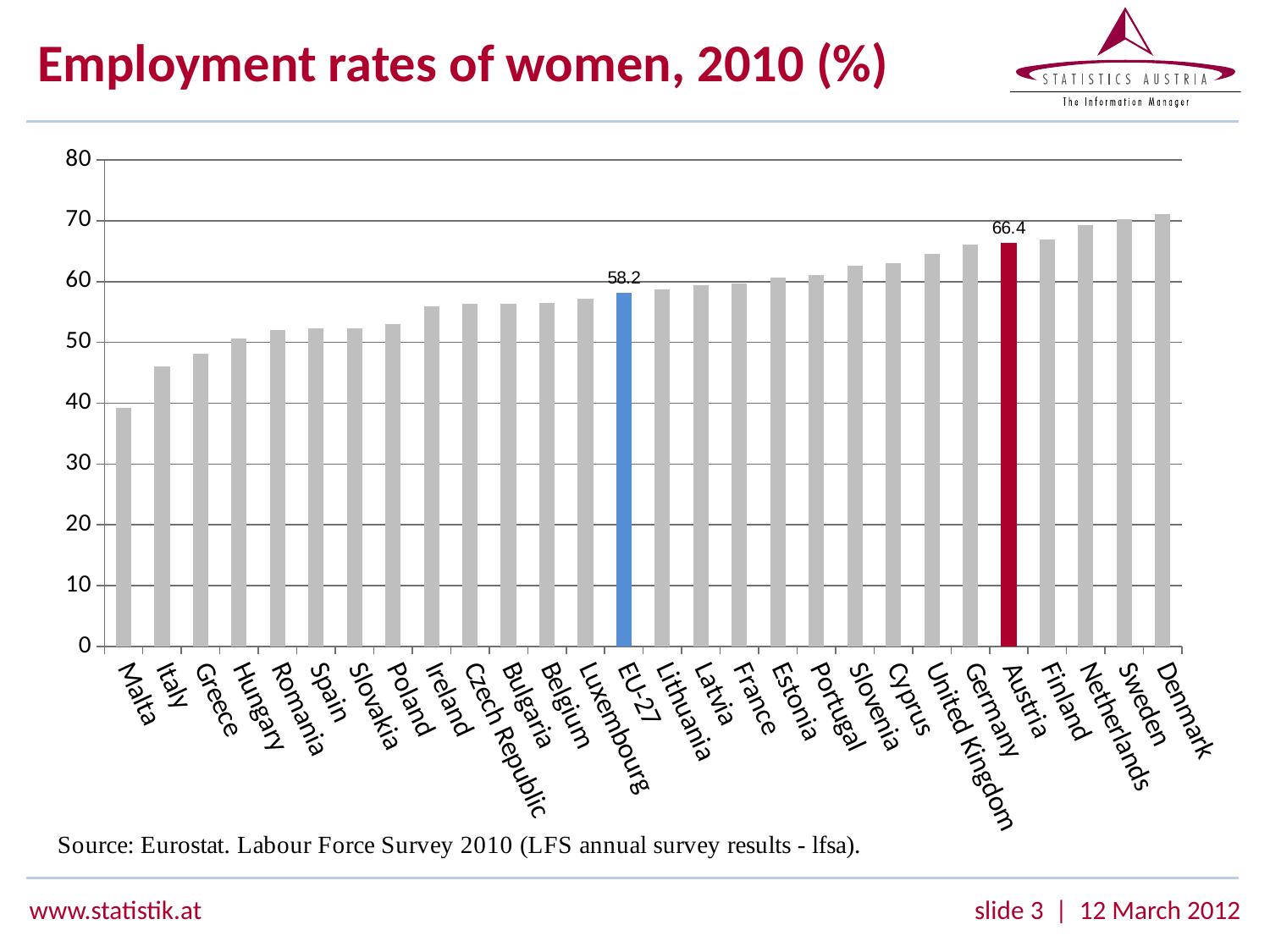
Which has a higher value, Austria or EU-27? Austria Is the value for Italy greater or less than 50? less Which country has the highest employment rate of women in the chart? Denmark What is the employment rate of women shown for Austria? 66.4 Is the value for Netherlands greater or less than 60? greater Do the values rise or fall from left to right along the x axis? rise What is the difference between the values for Austria and EU-27? 8.2 How many countries/categories are shown on the x axis? 28 What kind of chart is shown on the slide? bar chart What is the employment rate of women shown for EU-27? 58.2 Is the value for Malta greater or less than 40? less Which country has the lowest employment rate of women in the chart? Malta